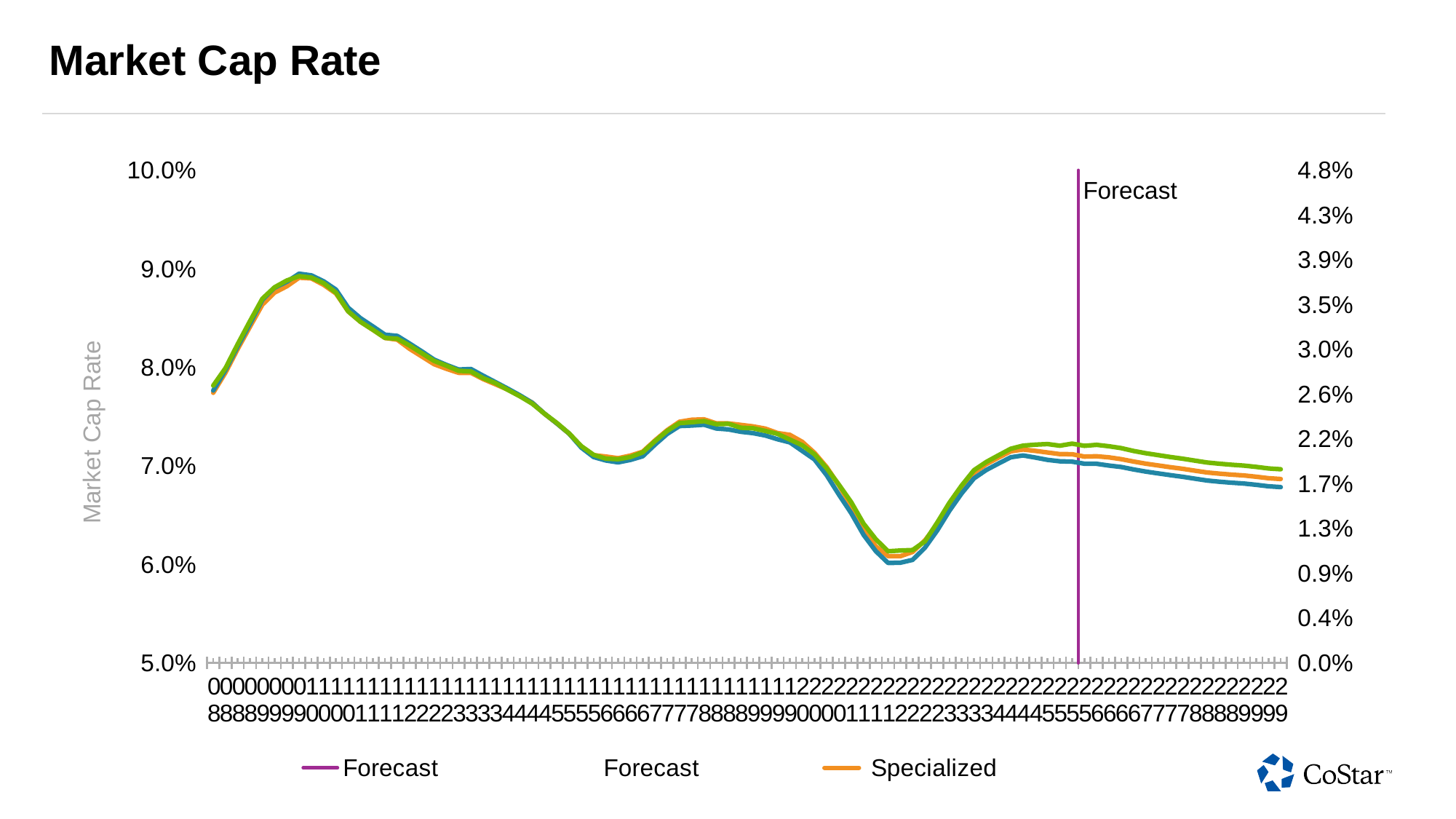
What kind of chart is shown on the slide? line chart What is the highest tick value shown on the left y axis? 10.0% After the vertical Forecast line, do the lines rise or fall toward the right end of the x axis? fall What label is written next to the vertical purple line on the chart? Forecast Is the value of the lines at the far left start of the x axis greater or less than 7.0%? greater Is the highest point reached by the lines greater or less than 8.0%? greater Is the lowest point reached by the lines greater or less than 7.0%? less What is the title of the chart? Market Cap Rate Do the lines end higher or lower at the right end of the x axis than where they start at the left? lower How many entries does the chart's legend list? 3